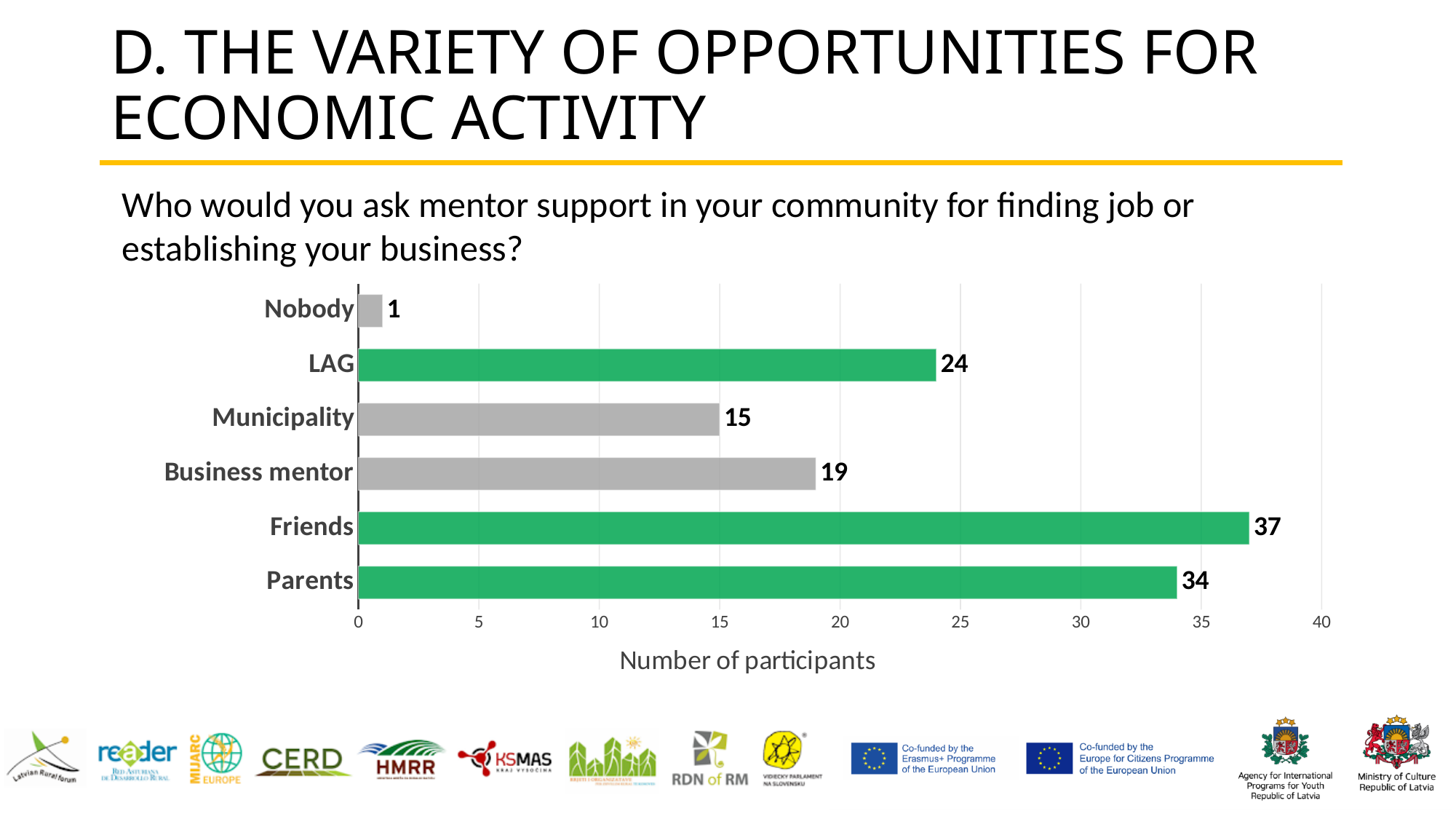
Which category has the lowest number of participants? Nobody What kind of chart is shown on the slide? Bar chart What is the difference between the values for LAG and Municipality? 9 How many categories are shown in the chart? 6 Which is larger, the value for Business mentor or the value for Municipality? Business mentor What is the value for LAG? 24 What is the value for Parents? 34 Which category has the highest number of participants? Friends How many participants would ask Friends for mentor support? 37 What is the label of the horizontal axis? Number of participants What is the value for Business mentor? 19 What is the difference between the values for Friends and Parents? 3